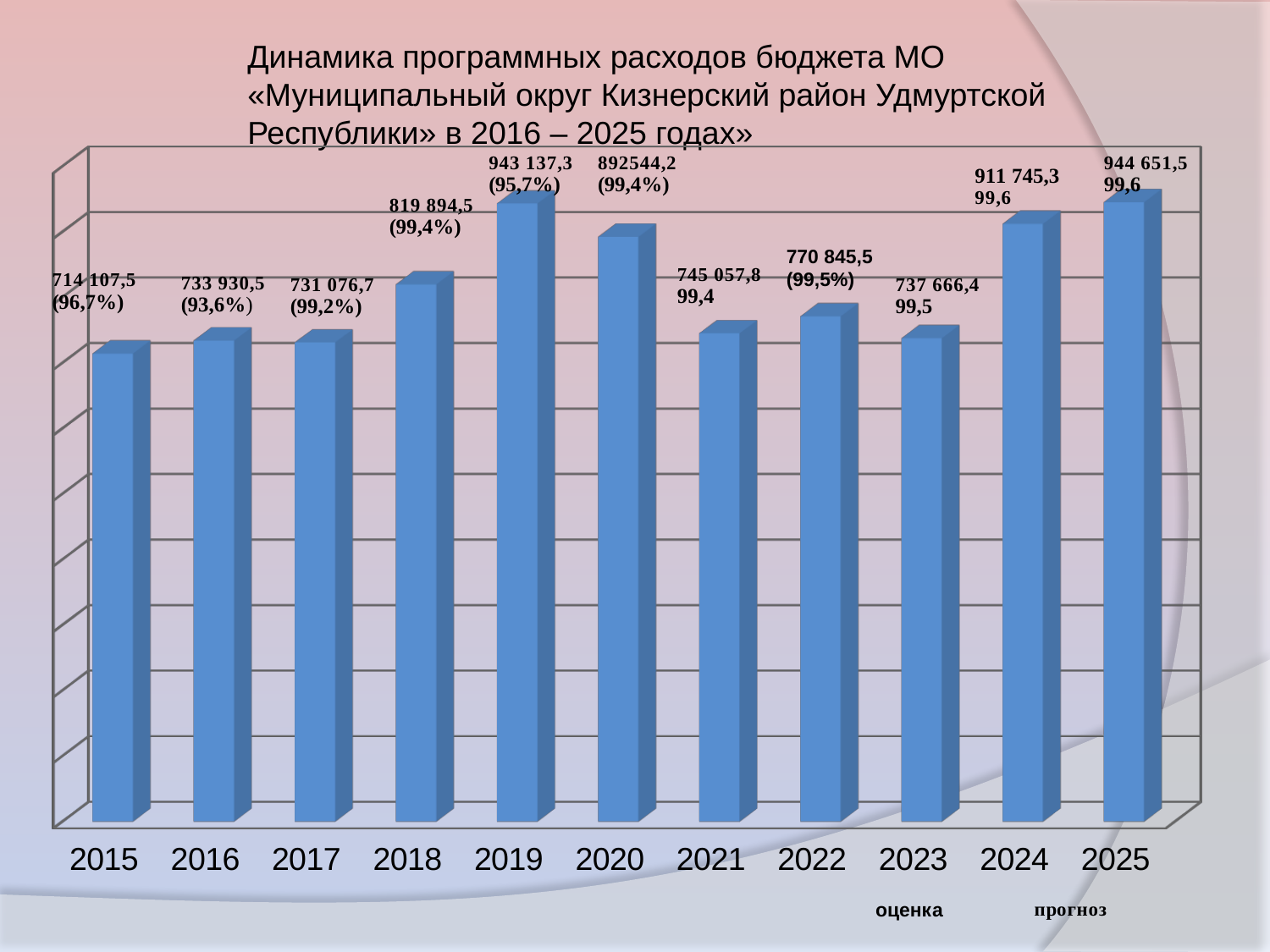
How many years are shown on the x axis? 11 Which year has the highest value? 2025 What is the difference between the values for 2019 and 2018? 123 242,8 Which year has the lowest value? 2015 What is the value shown for 2019? 943 137,3 What kind of chart is this? bar chart Which is larger, the value for 2020 or the value for 2021? 2020 Do the values rise or fall from 2015 to 2019? rise What is the value shown for 2024? 911 745,3 What is the value shown for 2022? 770 845,5 What is the difference between the values for 2025 and 2024? 32 906,2 What percentage is shown in parentheses for 2015? 96,7%